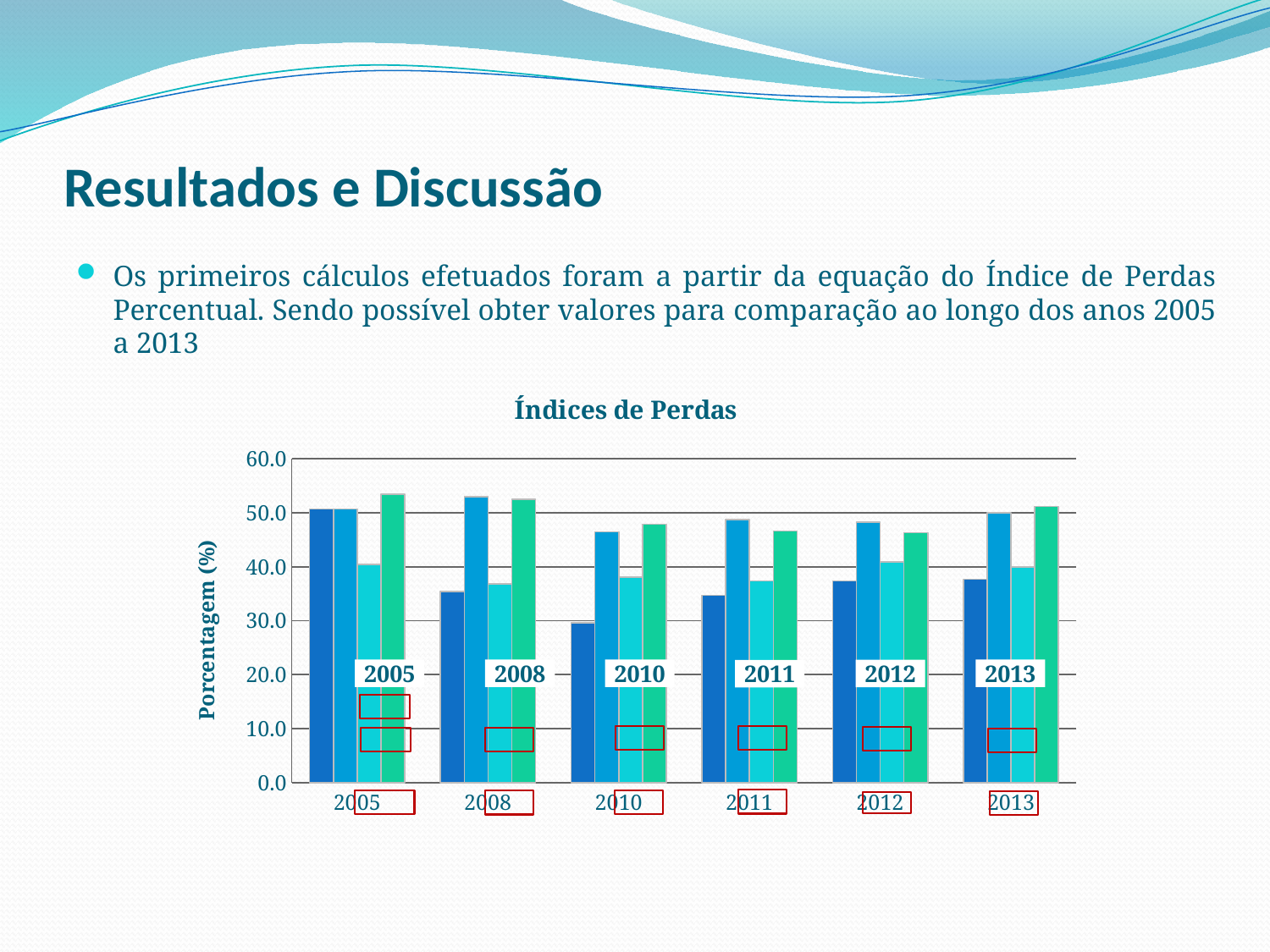
For 2010, which is larger: the first (dark blue) bar or the fourth (green) bar? the fourth (green) bar Is the value of the third (light blue) bar for 2011 greater or less than 40.0? less What is the label of the vertical axis of the chart? Porcentagem (%) Is the value of the fourth (green) bar for 2010 greater or less than 50.0? less Among the first (dark blue) bars, which year has the lowest value? 2010 How many year categories are shown on the x axis of the chart? 6 Is the value of the fourth (green) bar for 2005 greater or less than 50.0? greater What kind of chart is shown on the slide? bar chart Among the first (dark blue) bars, which year has the highest value? 2005 What is the title of the chart? Índices de Perdas